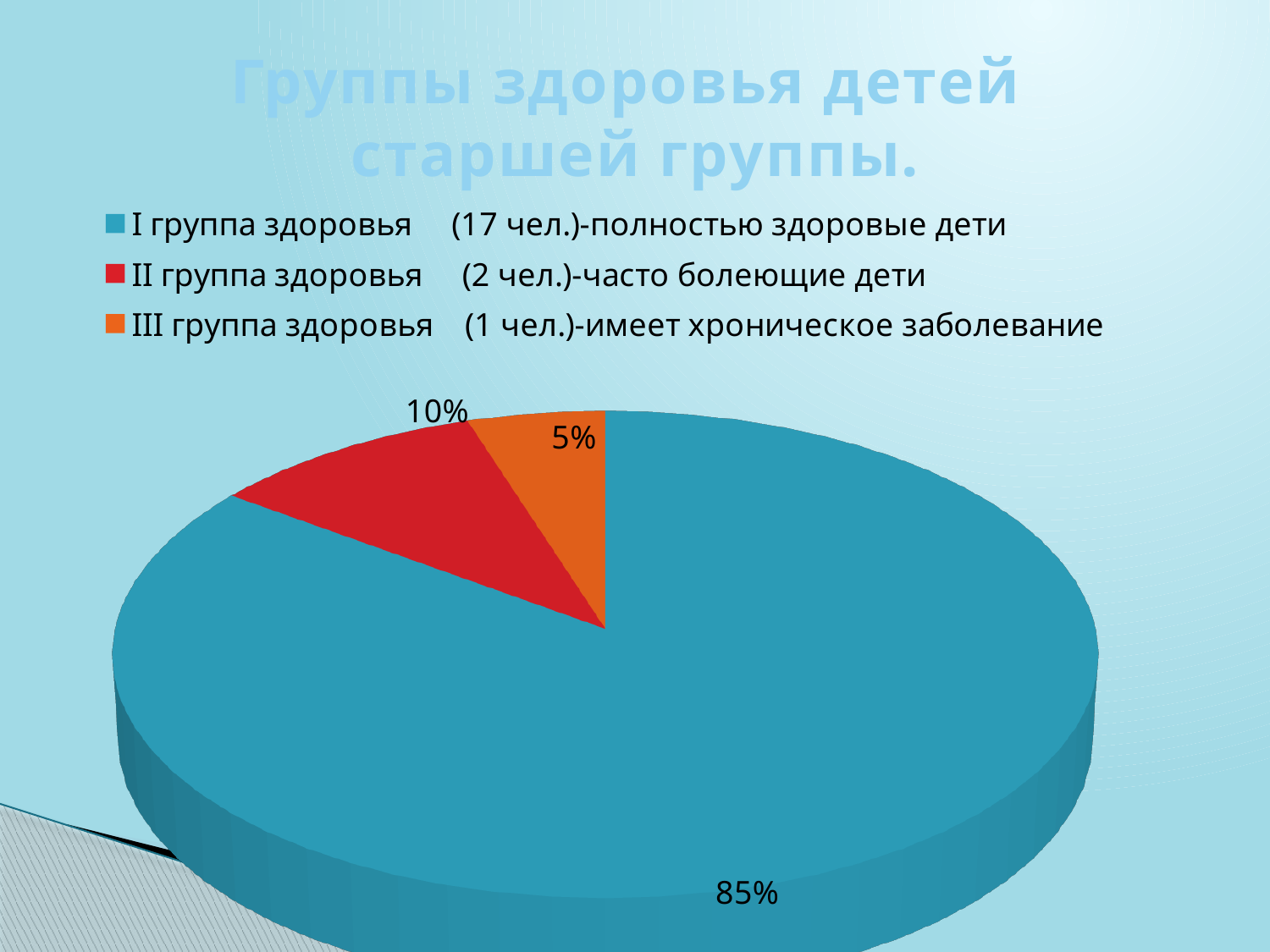
What colour is the slice for II группа здоровья? red What is the difference in percentage points between the I группа здоровья slice and the II группа здоровья slice? 75 Which health group has the largest slice of the pie? I группа здоровья Which health group has the smallest slice of the pie? III группа здоровья How many entries does the legend list? 3 What kind of chart is shown on the slide? pie chart What percentage share does the I группа здоровья slice have? 85% What percentage share does the III группа здоровья slice have? 5% What is the title of the chart? Группы здоровья детей старшей группы. How many slices does the pie chart have? 3 Which slice is larger, II группа здоровья or III группа здоровья? II группа здоровья What percentage share does the II группа здоровья slice have? 10%